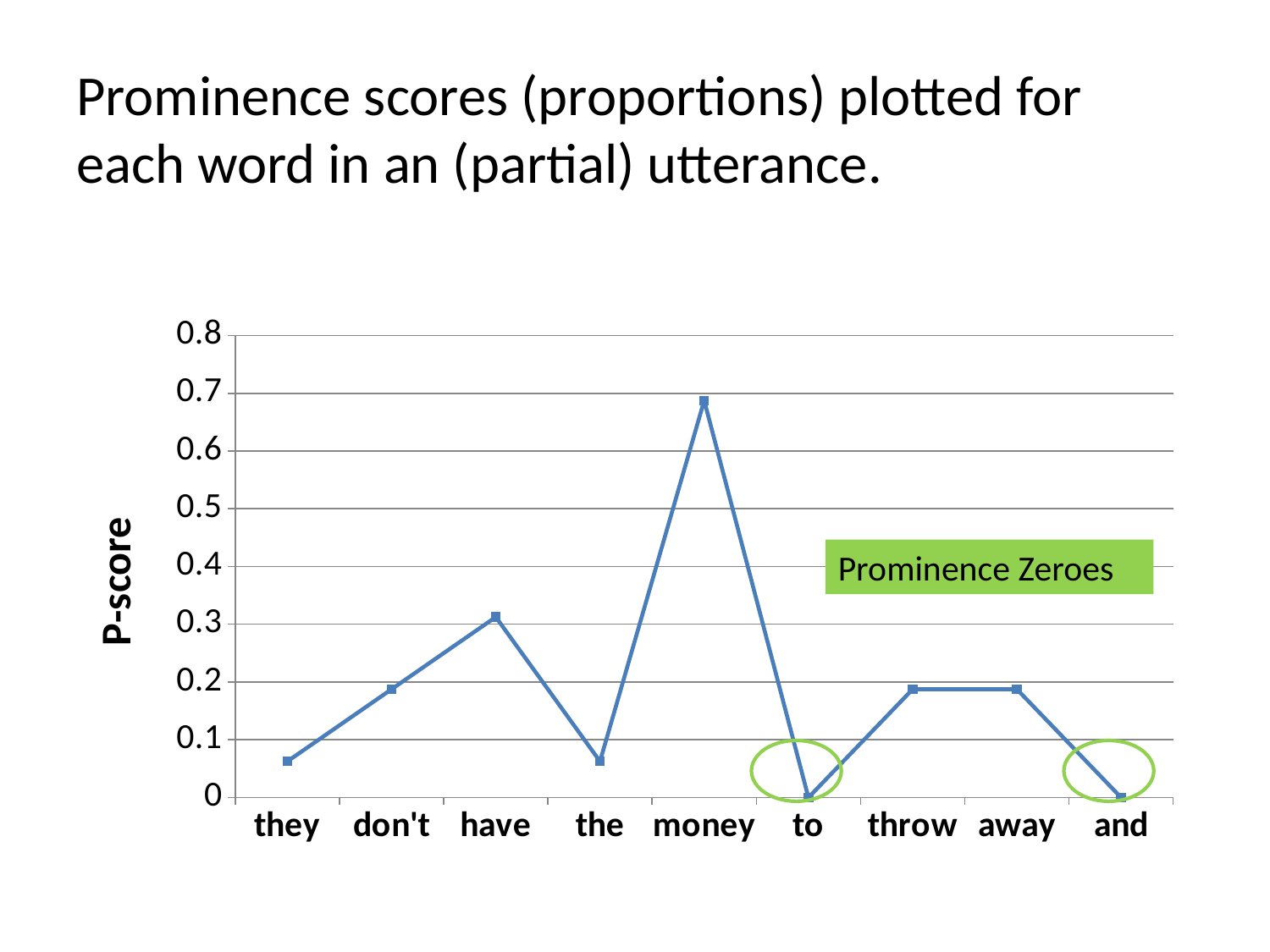
How many words are plotted along the x axis? 9 Does the P-score rise or fall from "money" to "to"? fall What is the P-score for the word "and"? 0 What is the P-score for the word "to"? 0 Is the P-score for "they" greater or less than 0.1? less Which has a higher P-score, "have" or "don't"? have Is the P-score for "money" greater or less than 0.6? greater What is the label on the y axis? P-score What kind of chart is shown on the slide? line chart How many words have a P-score of 0? 2 Which word has the highest P-score? money